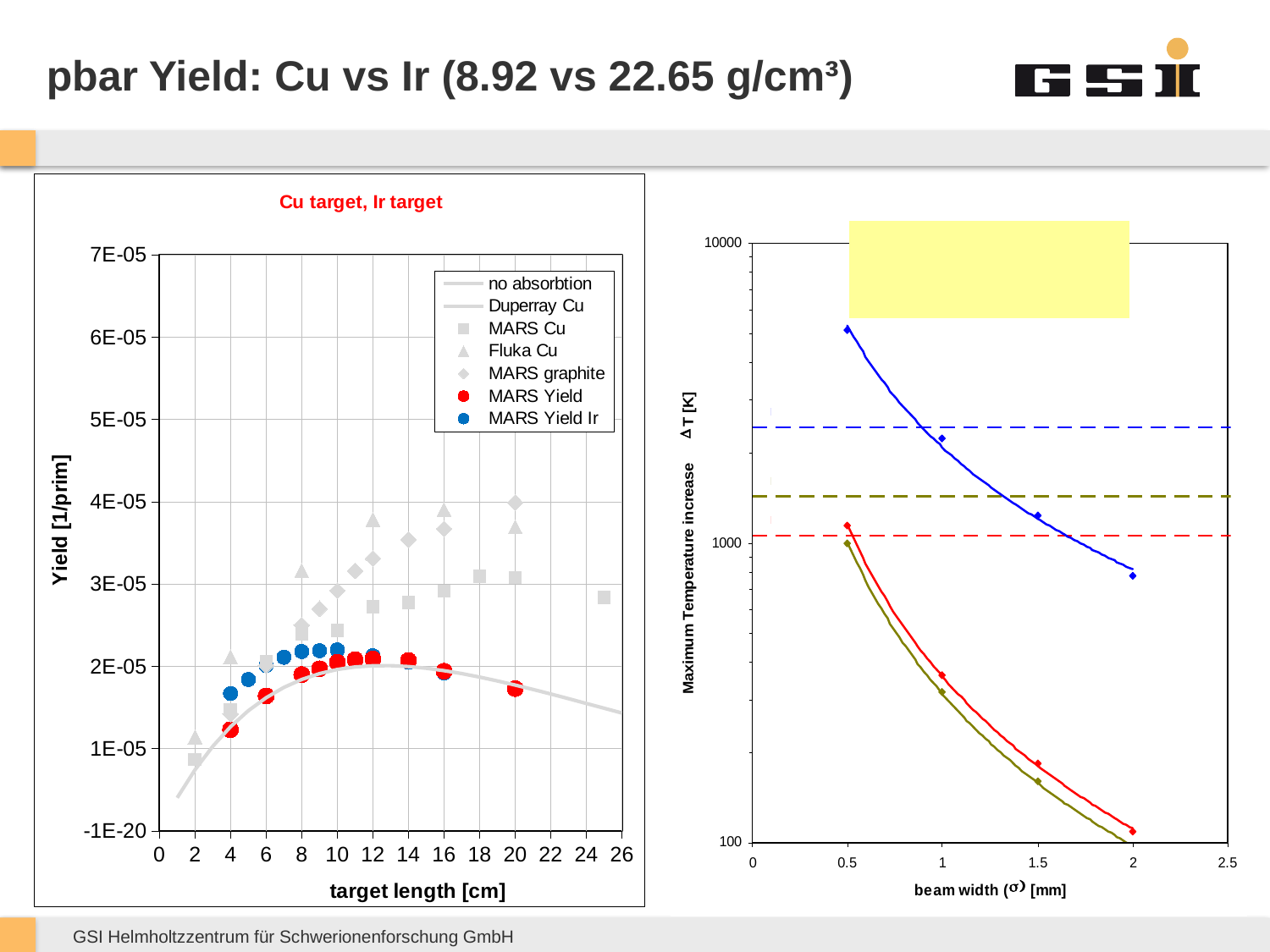
In the left chart, at a target length of 4 cm, which is larger: MARS Yield Ir or MARS Yield? MARS Yield Ir What kind of chart is the right chart? line chart In the left chart, is the MARS Yield Ir value at a target length of 4 cm greater or less than 1E-05? greater What kind of chart is the left chart? scatter chart In the left chart, is the MARS graphite value at a target length of 20 cm greater or less than 3E-05? greater What is the x-axis label of the right chart? beam width (σ) [mm] What is the title of the chart on the left? Cu target, Ir target How many series does the legend of the left chart list? 7 In the right chart, is the blue series value at a beam width of 0.5 mm greater or less than 1000? greater In the right chart, at a beam width of 1 mm, which is larger: the blue series or the red series? the blue series In the right chart, does the blue series rise or fall as beam width increases? fall In the left chart, does the MARS Yield series rise or fall between target lengths of 4 cm and 12 cm? rise